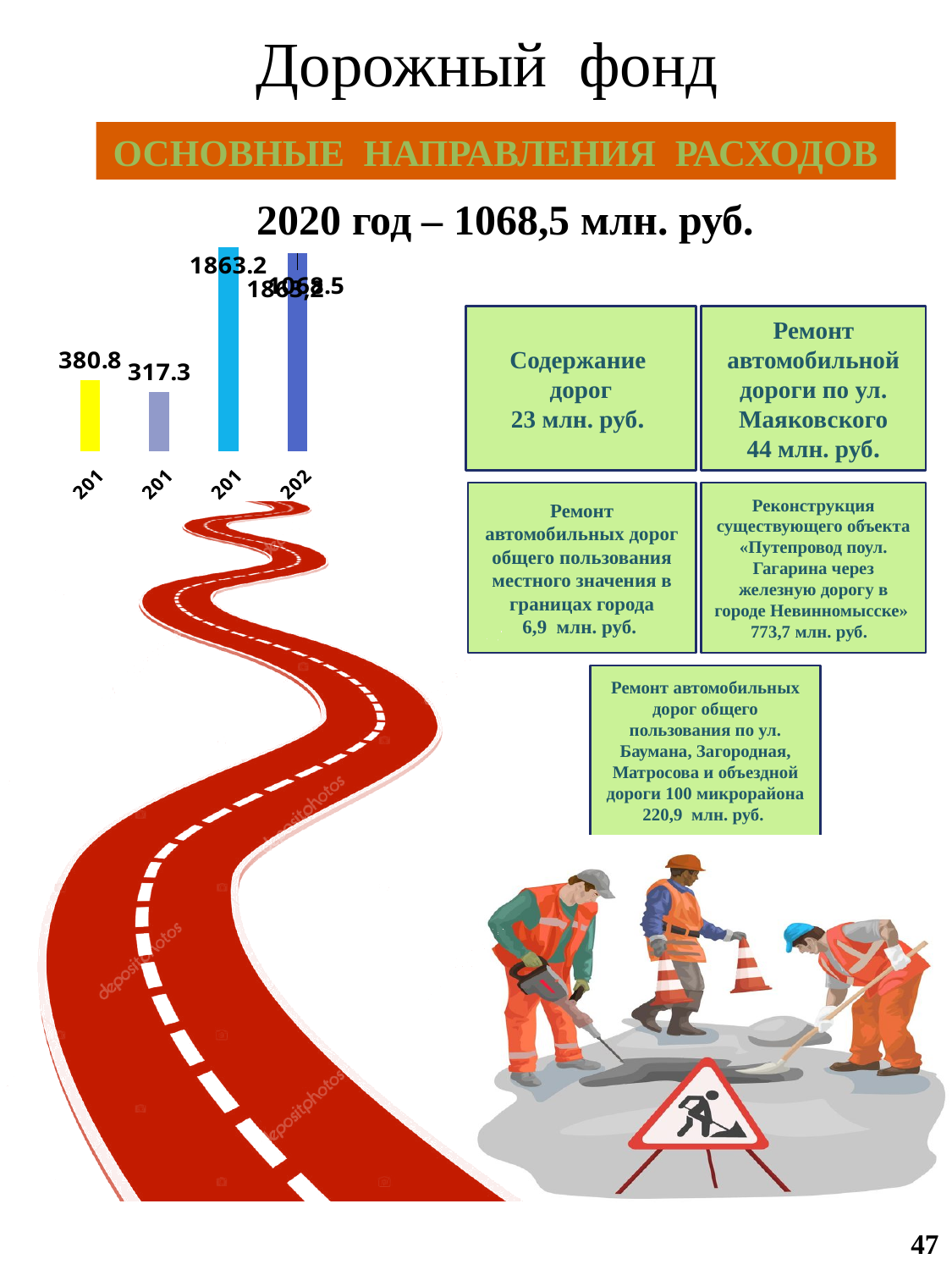
What colour is the third bar in the chart? light blue What kind of chart is shown on the slide? bar chart Which is larger, the value of the first bar or the value of the second bar? the first bar (380.8) What colour is the first (leftmost) bar in the chart? yellow What is the difference between the third bar (1863.2) and the first bar (380.8)? 1482.4 What is the difference between the first bar (380.8) and the second bar (317.3)? 63.5 What is the value shown above the first (leftmost, yellow) bar? 380.8 Which is larger, the value of the third bar or the value of the first bar? the third bar (1863.2) What is the value shown above the second bar? 317.3 What is the value shown above the third (light blue) bar? 1863.2 How many bars does the chart on the slide have? 4 Which bar is the lowest in the chart? the second bar (317.3)